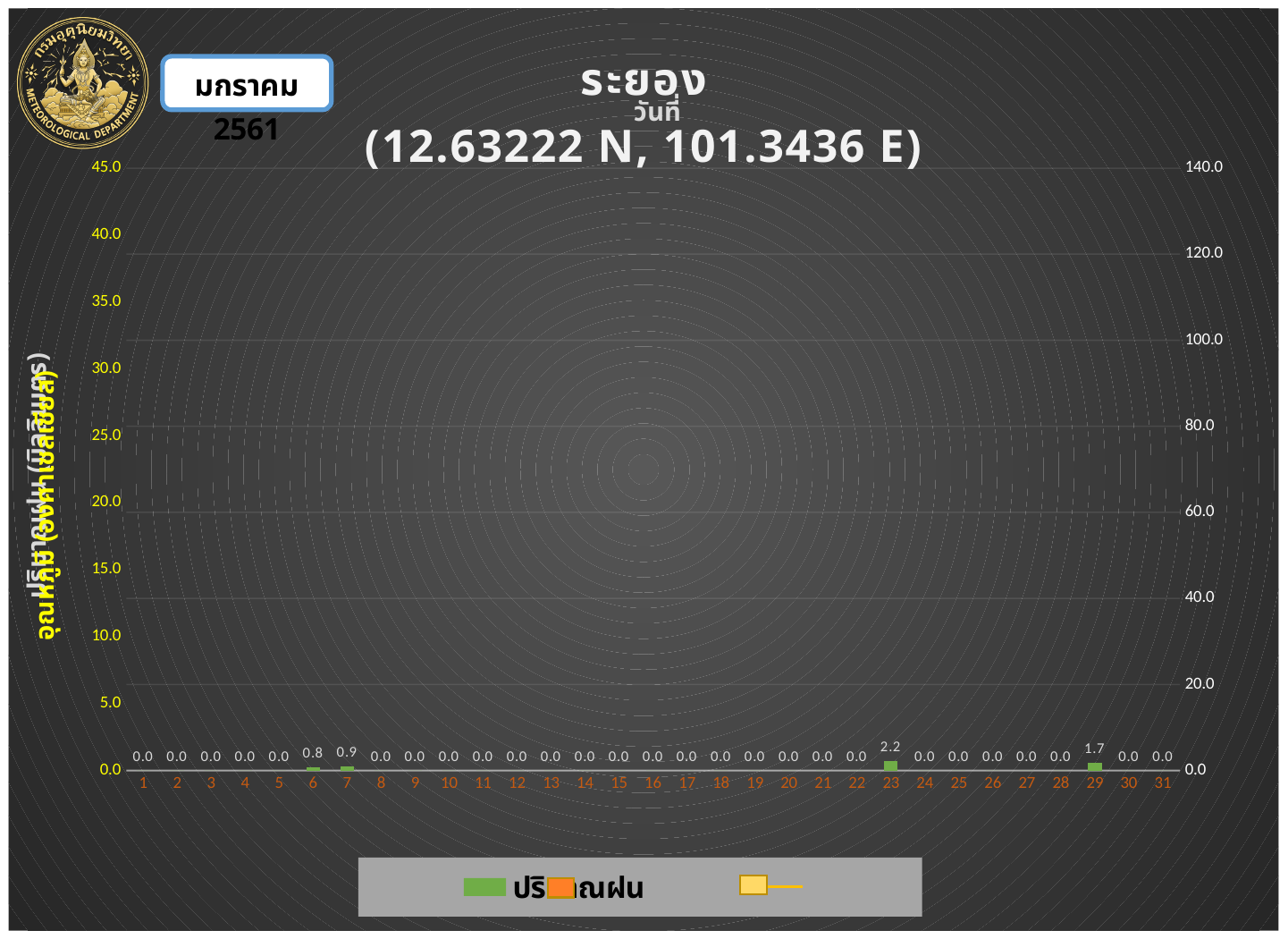
Which day has the highest rainfall value? 23 How many days are shown on the x axis? 31 What is the rainfall value shown for day 6? 0.8 What is the rainfall value shown for day 7? 0.9 Which is larger, the rainfall value for day 7 or for day 6? day 7 What is the rainfall value shown for day 23? 2.2 What is the rainfall value shown for day 15? 0.0 What coordinates are given in the chart title? 12.63222 N, 101.3436 E What is the difference between the rainfall values for day 23 and day 29? 0.5 What is the rainfall value shown for day 29? 1.7 What is the highest value shown on the right-hand axis? 140.0 What kind of chart is used to show the rainfall values? bar chart